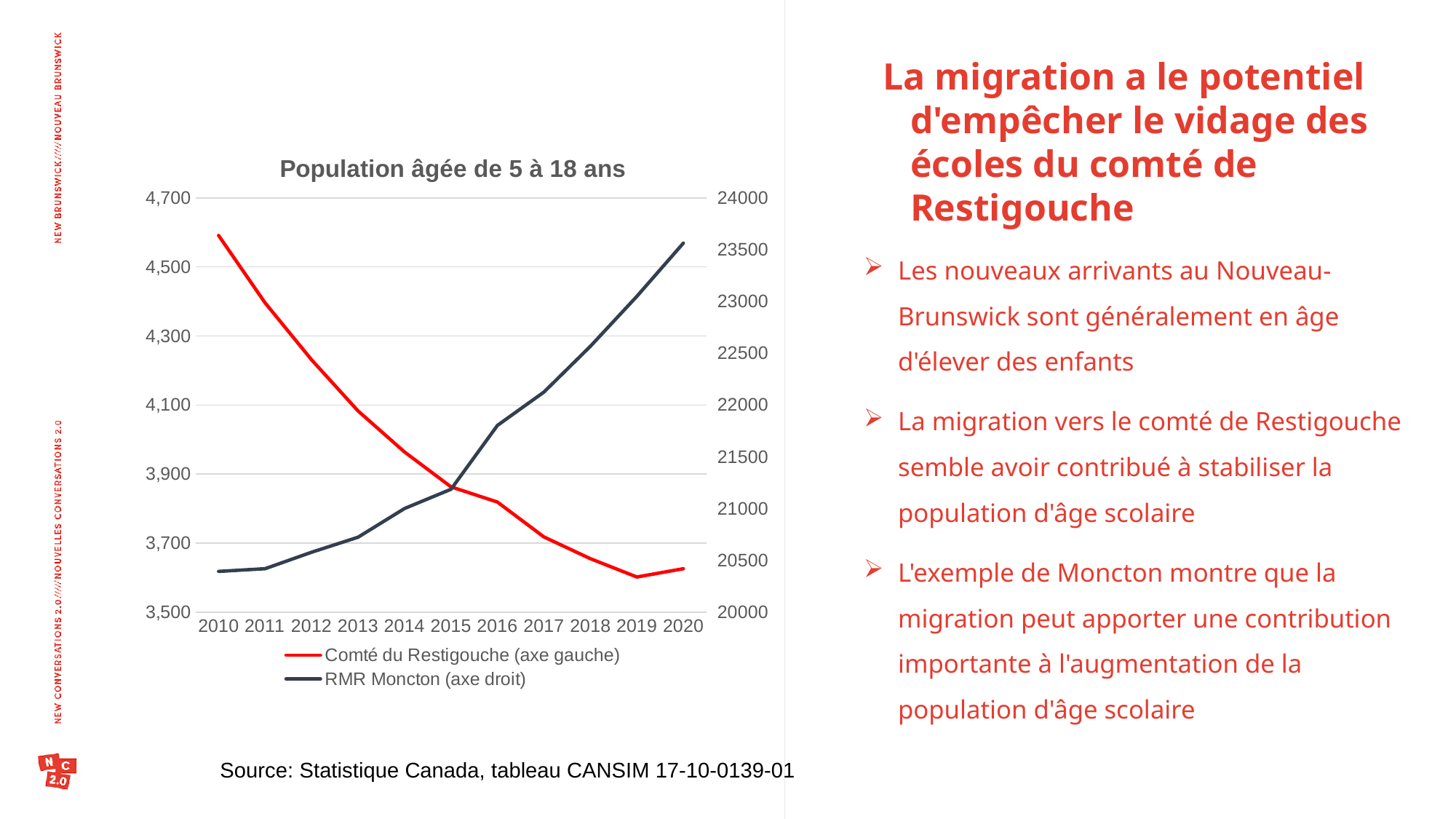
Is the RMR Moncton value for 2010 greater or less than 21000? less In which year is the RMR Moncton value highest? 2020 Does the Comté du Restigouche line rise or fall from 2010 to 2020? Fall Is the Comté du Restigouche value for 2010 greater or less than 4,500? greater What is the title of the chart? Population âgée de 5 à 18 ans What kind of chart is shown on the slide? Line chart Does the RMR Moncton line rise or fall from 2010 to 2020? Rise Is the Comté du Restigouche value for 2020 greater or less than 3,700? less How many years are plotted along the x axis of the chart? 11 In which year is the Comté du Restigouche value lowest? 2019 How many series does the chart's legend list? 2 In which year is the Comté du Restigouche value highest? 2010